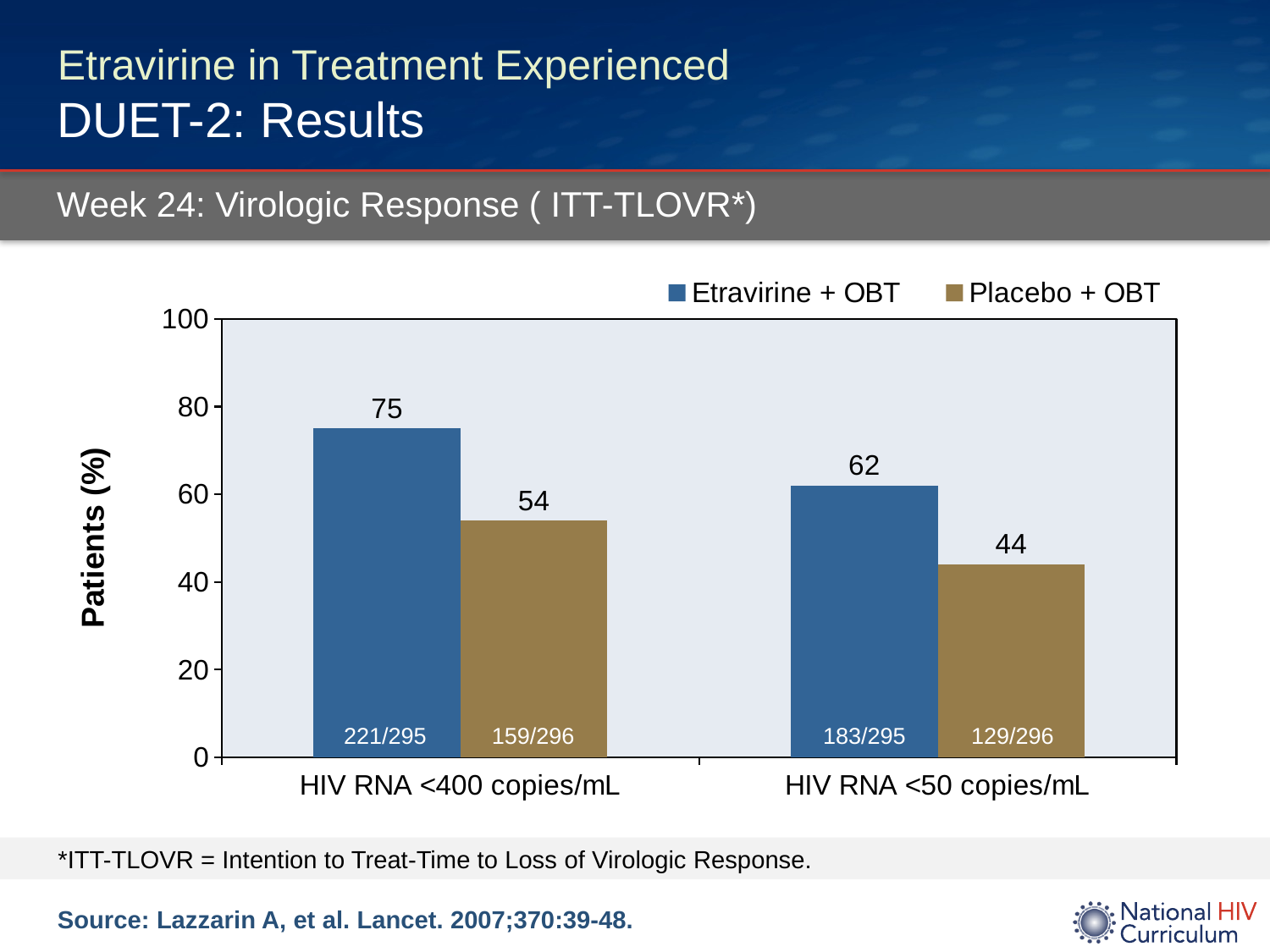
What type of chart is shown on the slide? Bar chart What percentage of patients in the Etravirine + OBT group achieved HIV RNA <400 copies/mL? 75 What is the difference in percentage points between Etravirine + OBT and Placebo + OBT for HIV RNA <400 copies/mL? 21 For HIV RNA <50 copies/mL, which group has the larger percentage of patients, Etravirine + OBT or Placebo + OBT? Etravirine + OBT What is the difference in percentage points between Etravirine + OBT and Placebo + OBT for HIV RNA <50 copies/mL? 18 How many series does the legend list? 2 What is the fraction of patients shown inside the Etravirine + OBT bar for HIV RNA <50 copies/mL? 183/295 Which bar shows the highest percentage of patients? Etravirine + OBT, HIV RNA <400 copies/mL What percentage of patients in the Placebo + OBT group achieved HIV RNA <50 copies/mL? 44 What is the fraction of patients shown inside the Placebo + OBT bar for HIV RNA <400 copies/mL? 159/296 Which bar shows the lowest percentage of patients? Placebo + OBT, HIV RNA <50 copies/mL How many categories are shown on the x axis? 2